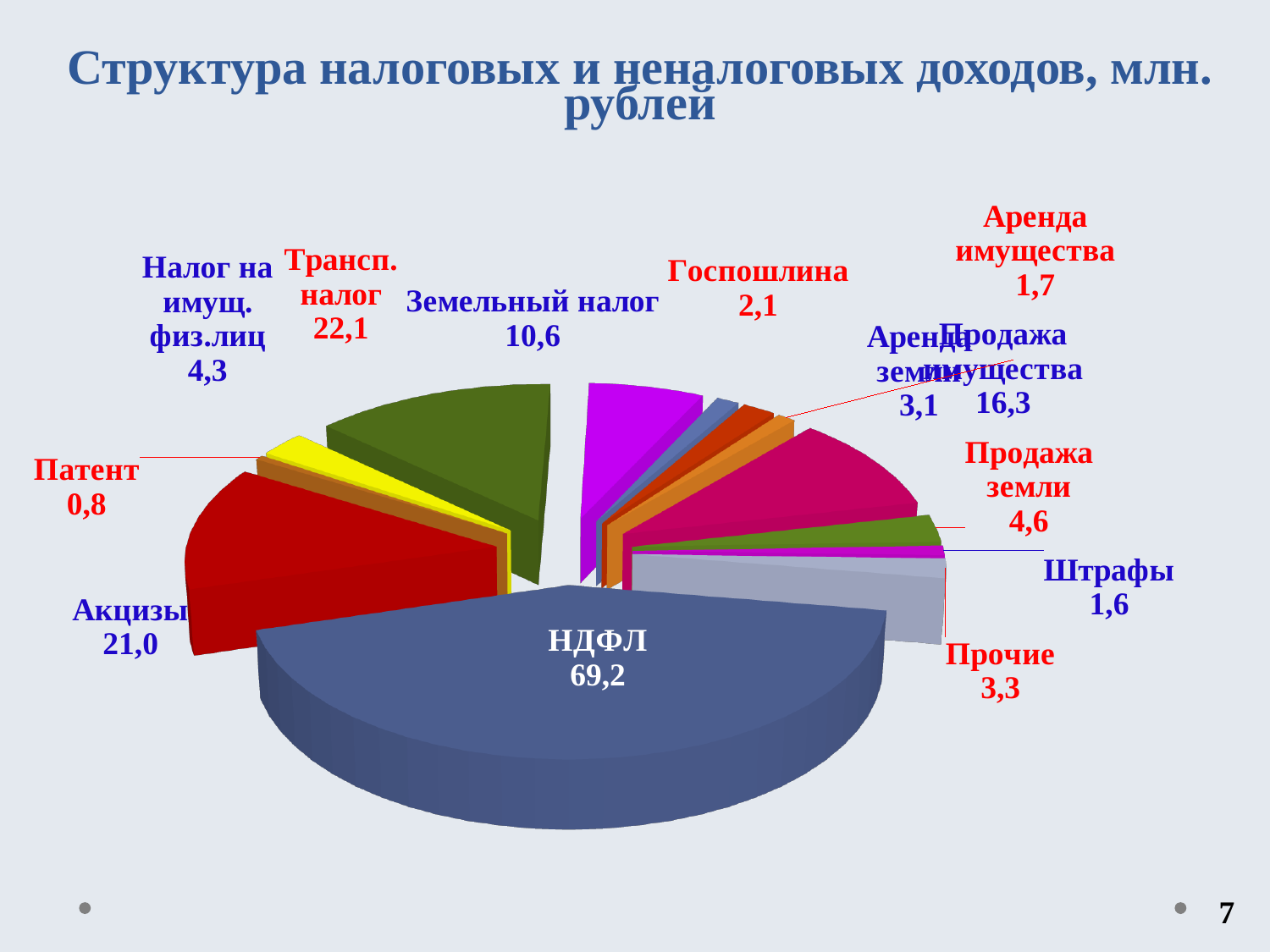
What kind of chart is shown on the slide? Pie chart What is the title of the chart? Структура налоговых и неналоговых доходов, млн. рублей What is the value for Акцизы? 21,0 What is the value for Земельный налог? 10,6 What is the value for Штрафы? 1,6 What is the difference between Трансп. налог and Акцизы? 1,1 What is the value for Госпошлина? 2,1 Which is larger, Земельный налог or Налог на имущ. физ.лиц? Земельный налог How many categories (slices) does the pie chart have? 13 Which category has the smallest value? Патент What is the value for НДФЛ? 69,2 Which category has the largest value? НДФЛ